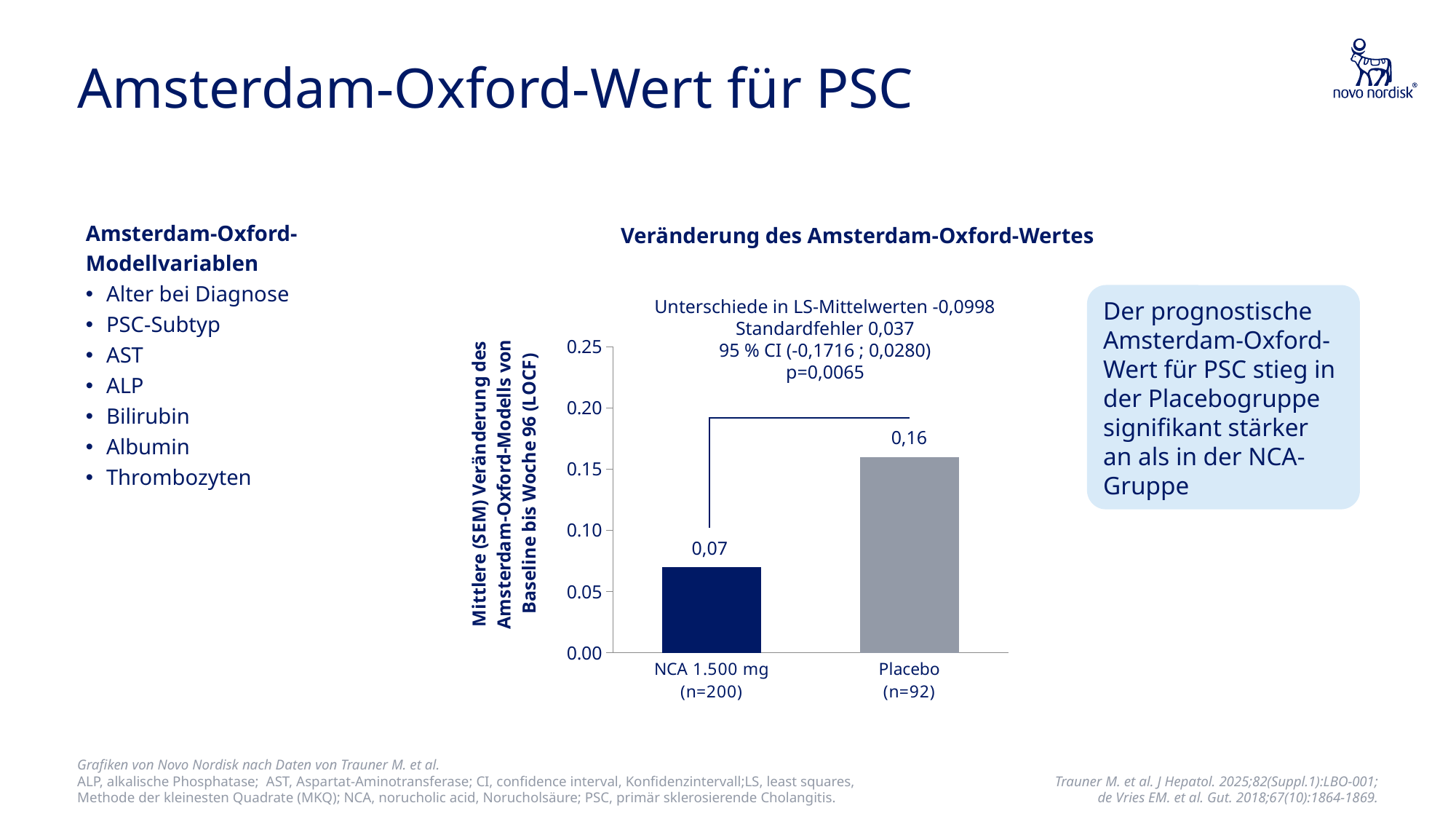
Is the value for Placebo greater or less than 0.20? less What is the value for NCA 1.500 mg (n=200) in the chart? 0,07 Is the value for NCA 1.500 mg greater or less than 0.10? less What is the title of the chart? Veränderung des Amsterdam-Oxford-Wertes Which group has the higher bar in the chart? Placebo (n=92) What p-value is shown above the bars in the chart? p=0,0065 What kind of chart is shown on the slide? bar chart Which group has the lower bar in the chart? NCA 1.500 mg (n=200) What is the difference between the Placebo value and the NCA 1.500 mg value? 0,09 How many bars are shown in the chart? 2 What is the value for Placebo (n=92) in the chart? 0,16 Is the value for Placebo larger or smaller than the value for NCA 1.500 mg? larger